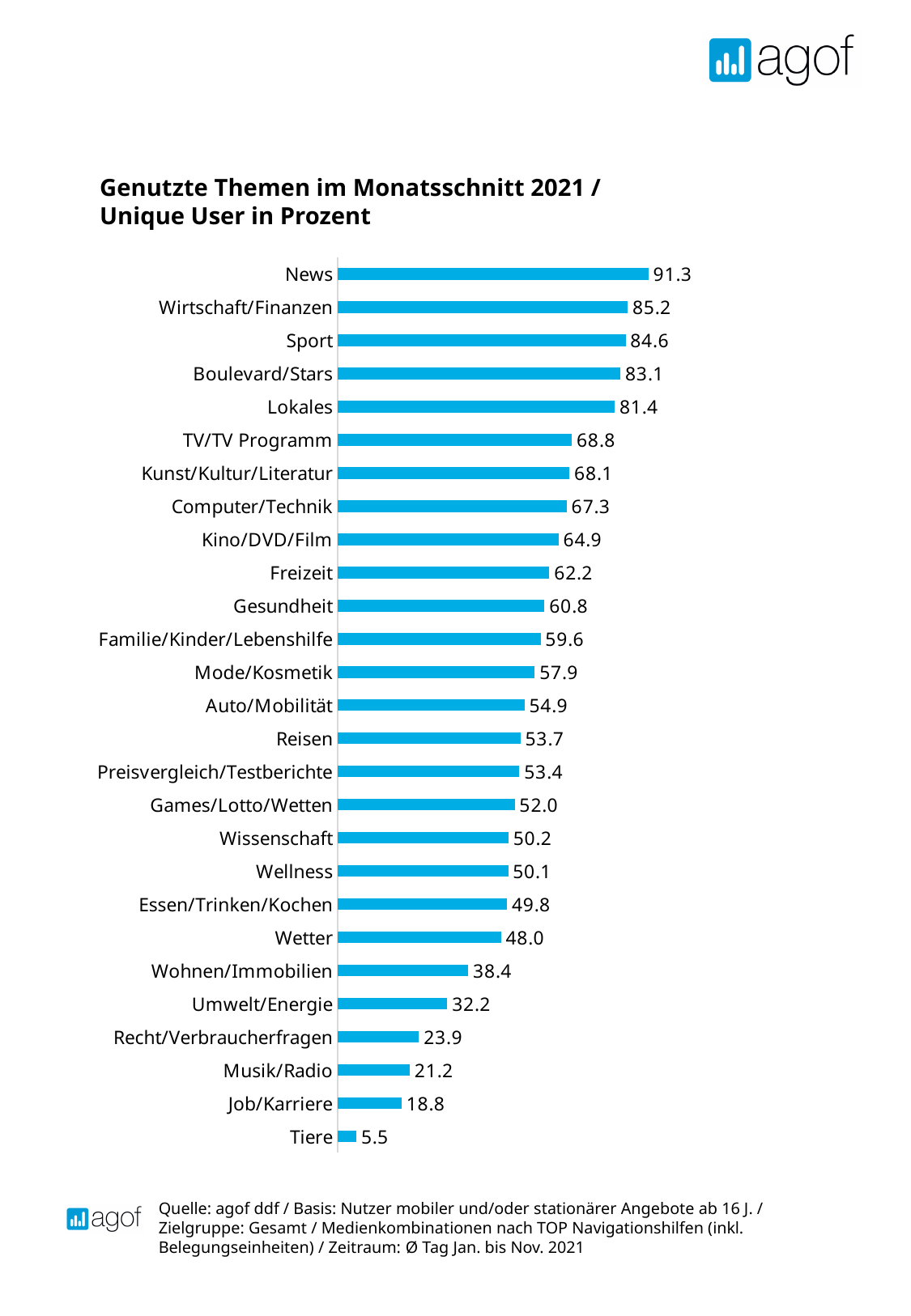
What is the difference between the values for Sport and Lokales? 3.2 Which is larger, the value for Wohnen/Immobilien or the value for Recht/Verbraucherfragen? Wohnen/Immobilien What is the difference between the values for News and Tiere? 85.8 How many categories are shown in the chart? 27 What is the value for News? 91.3 What kind of chart is shown on the slide? Bar chart What is the value for Umwelt/Energie? 32.2 Which category has the lowest value? Tiere Which category has the highest value? News Which is larger, the value for Freizeit or the value for Gesundheit? Freizeit What is the title of the chart? Genutzte Themen im Monatsschnitt 2021 / Unique User in Prozent What is the value for Wetter? 48.0